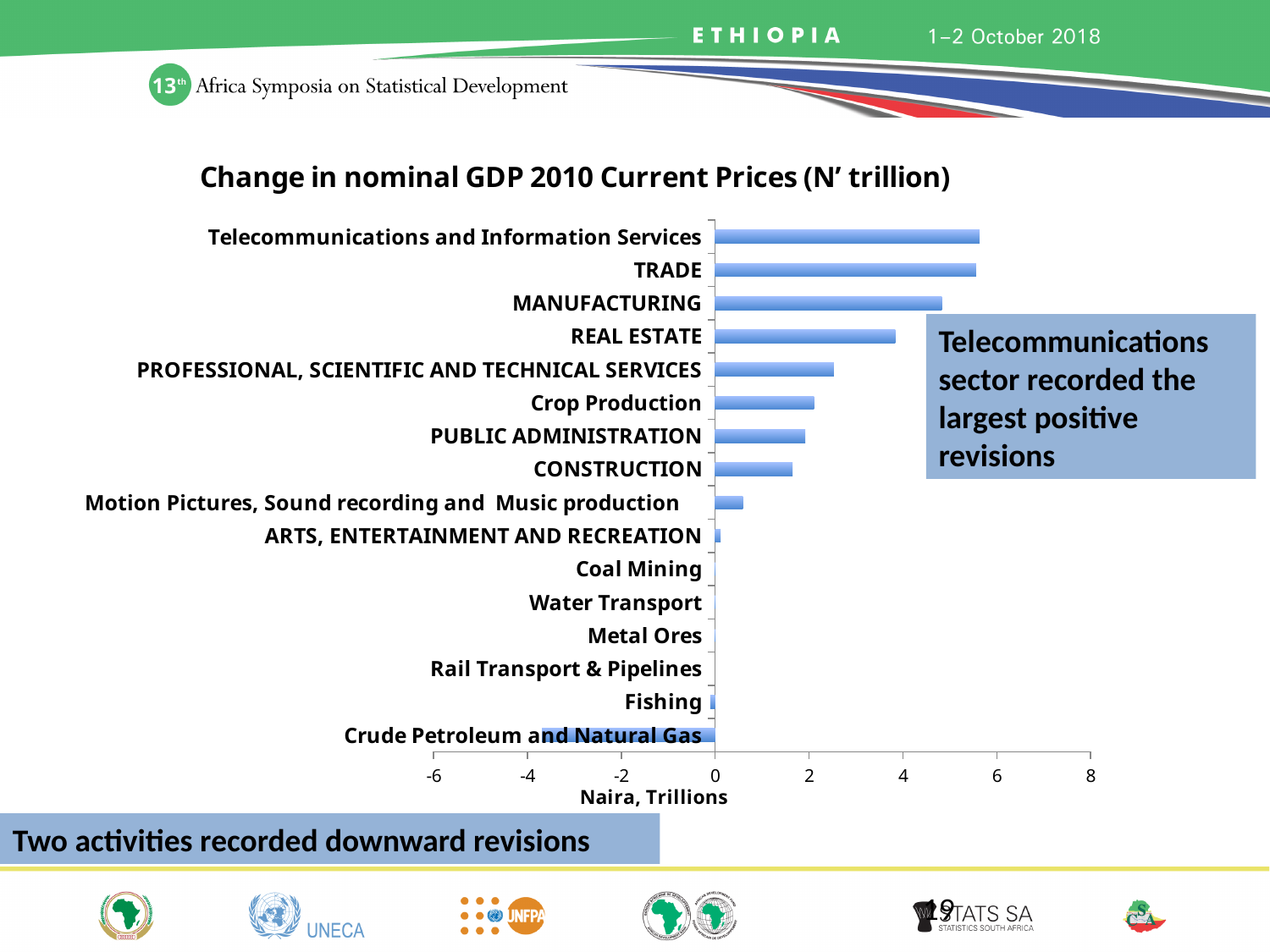
Which activity has the lowest (most negative) change in nominal GDP? Crude Petroleum and Natural Gas What is the title of the chart? Change in nominal GDP 2010 Current Prices (N' trillion) Is the value for Crude Petroleum and Natural Gas greater or less than -2? less How many activities recorded a downward (negative) revision? 2 What is the label on the horizontal axis of the chart? Naira, Trillions Is the value for MANUFACTURING greater or less than 4? greater Which is larger, the value for MANUFACTURING or the value for REAL ESTATE? MANUFACTURING What kind of chart is shown on the slide? Bar chart How many activities (categories) are listed on the chart? 16 Is the value for REAL ESTATE greater or less than 4? less Which activity has the largest positive change in nominal GDP? Telecommunications and Information Services